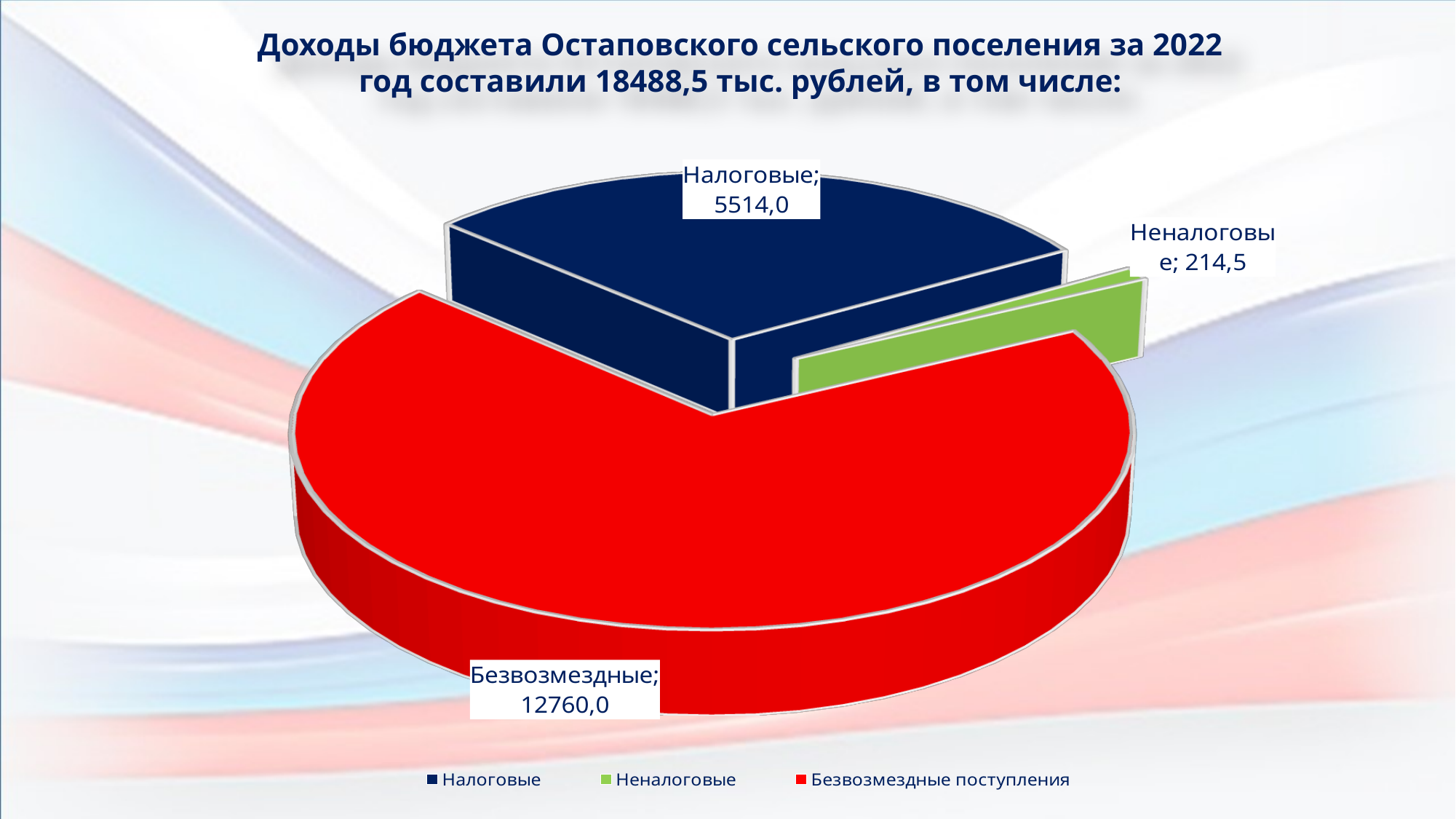
How many slices does the pie chart have? 3 Which category has the largest slice of the pie? Безвозмездные What colour is the Безвозмездные поступления slice in the pie chart? Red What is the difference between the values for Налоговые and Неналоговые? 5299,5 What is the value for Неналоговые on the pie chart? 214,5 What is the value for Безвозмездные on the pie chart? 12760,0 What kind of chart is shown on the slide? Pie chart What is the value for Налоговые on the pie chart? 5514,0 Which category has the smallest slice of the pie? Неналоговые What is the difference between the values for Безвозмездные and Налоговые? 7246,0 Which is larger, the value for Налоговые or the value for Неналоговые? Налоговые How many entries does the legend list? 3